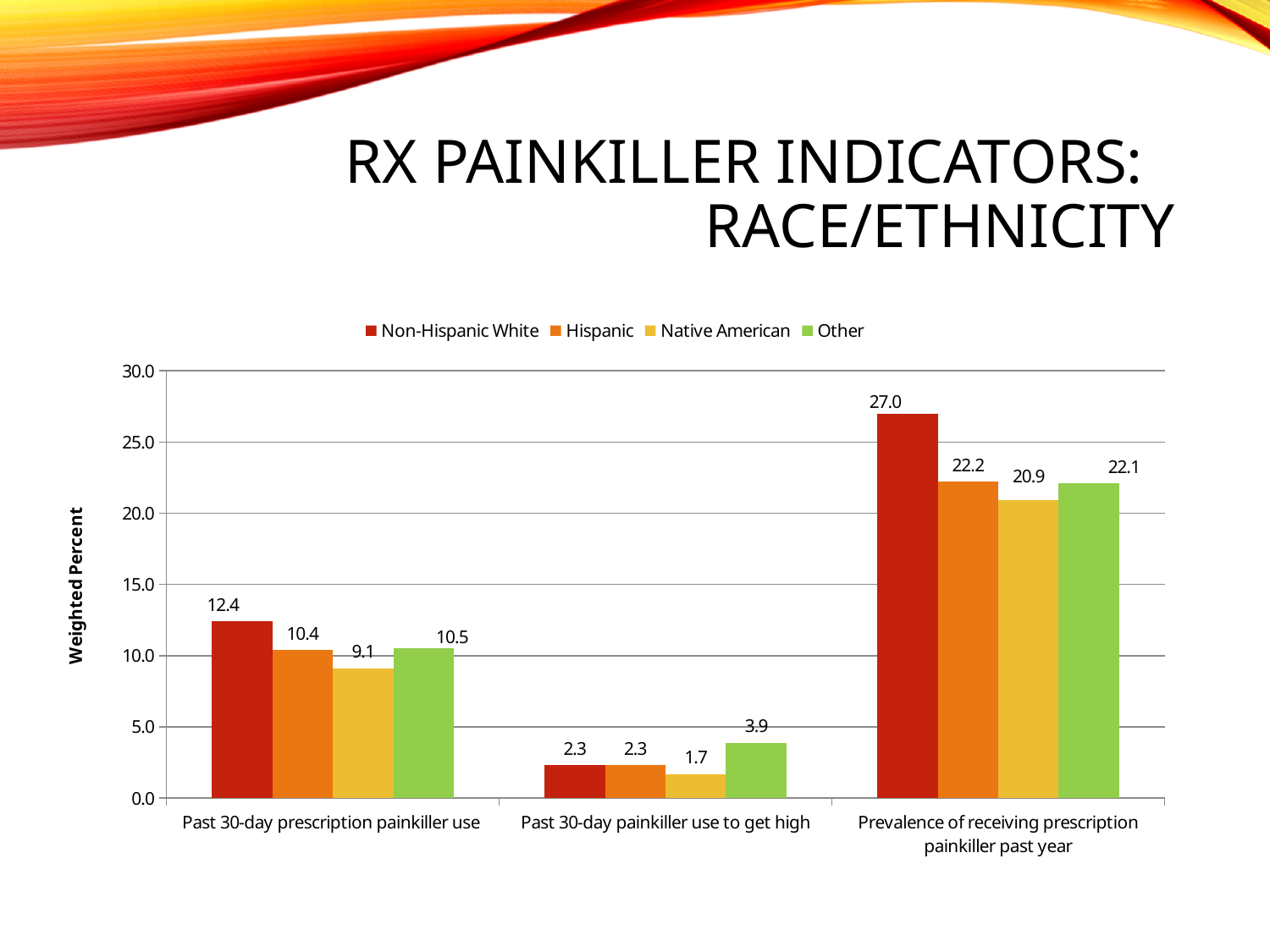
What is the value for Non-Hispanic White for Past 30-day prescription painkiller use? 12.4 What kind of chart is shown on the slide? Bar chart Which is larger for Past 30-day prescription painkiller use: the Hispanic value or the Other value? Other What is the difference between the Non-Hispanic White and Hispanic values for Prevalence of receiving prescription painkiller past year? 4.8 Is the Non-Hispanic White value for Prevalence of receiving prescription painkiller past year greater or less than 25.0? greater Which group has the lowest value for Past 30-day painkiller use to get high? Native American What is the value for Other for Past 30-day painkiller use to get high? 3.9 What is the label of the y axis? Weighted Percent How many categories are shown on the x axis? 3 Which group has the highest value for Prevalence of receiving prescription painkiller past year? Non-Hispanic White How many series does the legend list? 4 What is the value for Native American for Prevalence of receiving prescription painkiller past year? 20.9